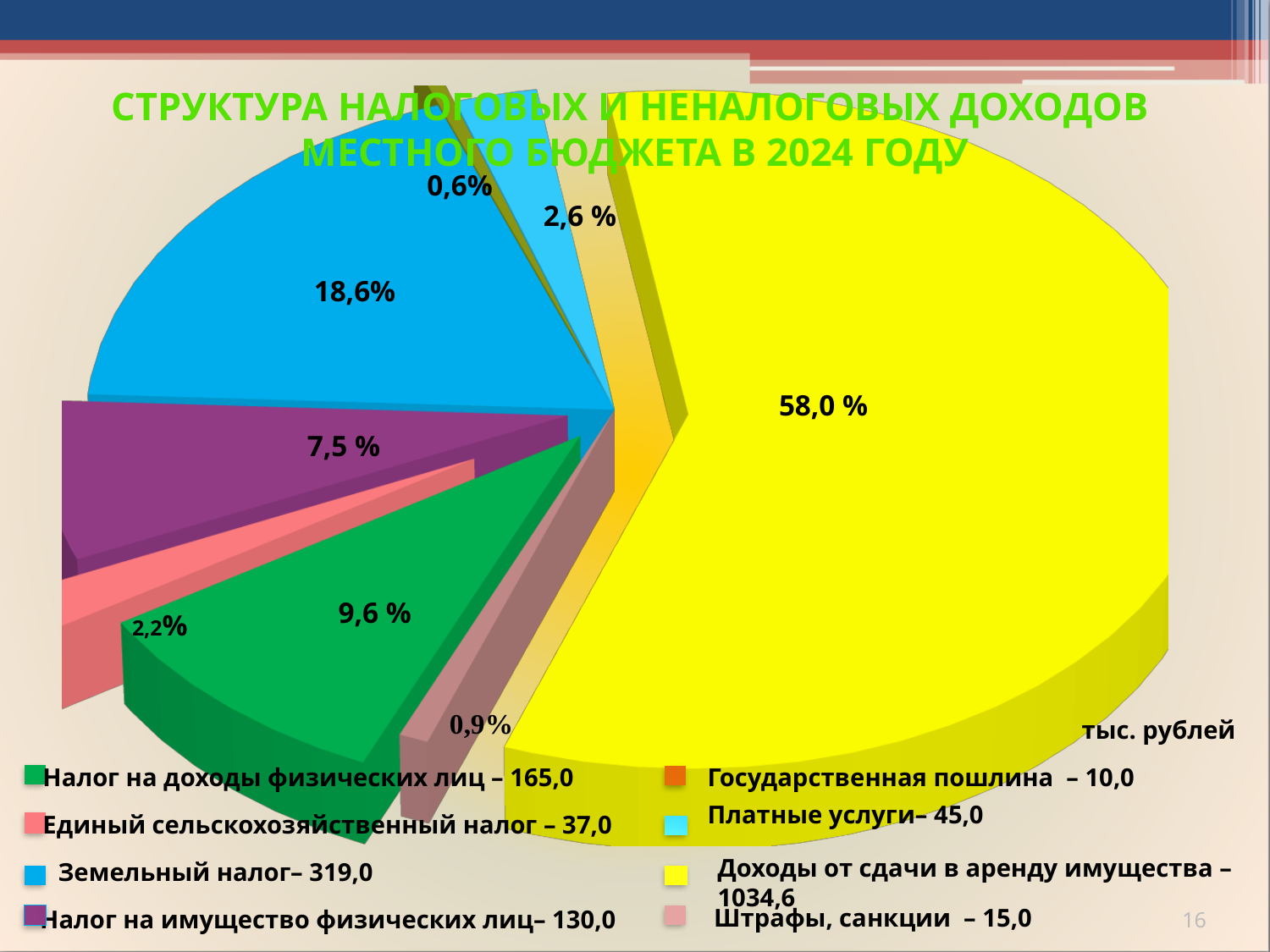
What share of the pie does Земельный налог have? 18,6% What colour is the slice for Доходы от сдачи в аренду имущества? yellow Which category has the largest share of the pie? Доходы от сдачи в аренду имущества Which category has the smallest share of the pie? Государственная пошлина Which is larger: Налог на имущество физических лиц or Единый сельскохозяйственный налог? Налог на имущество физических лиц How many categories does the legend of the pie chart list? 8 In what units are the legend values given? тыс. рублей What kind of chart is shown on the slide? pie chart What share of the pie does Доходы от сдачи в аренду имущества have? 58,0 % What value is given in the legend for Платные услуги? 45,0 What is the difference between the values for Налог на доходы физических лиц (165,0) and Налог на имущество физических лиц (130,0)? 35,0 What value is given in the legend for Налог на доходы физических лиц? 165,0